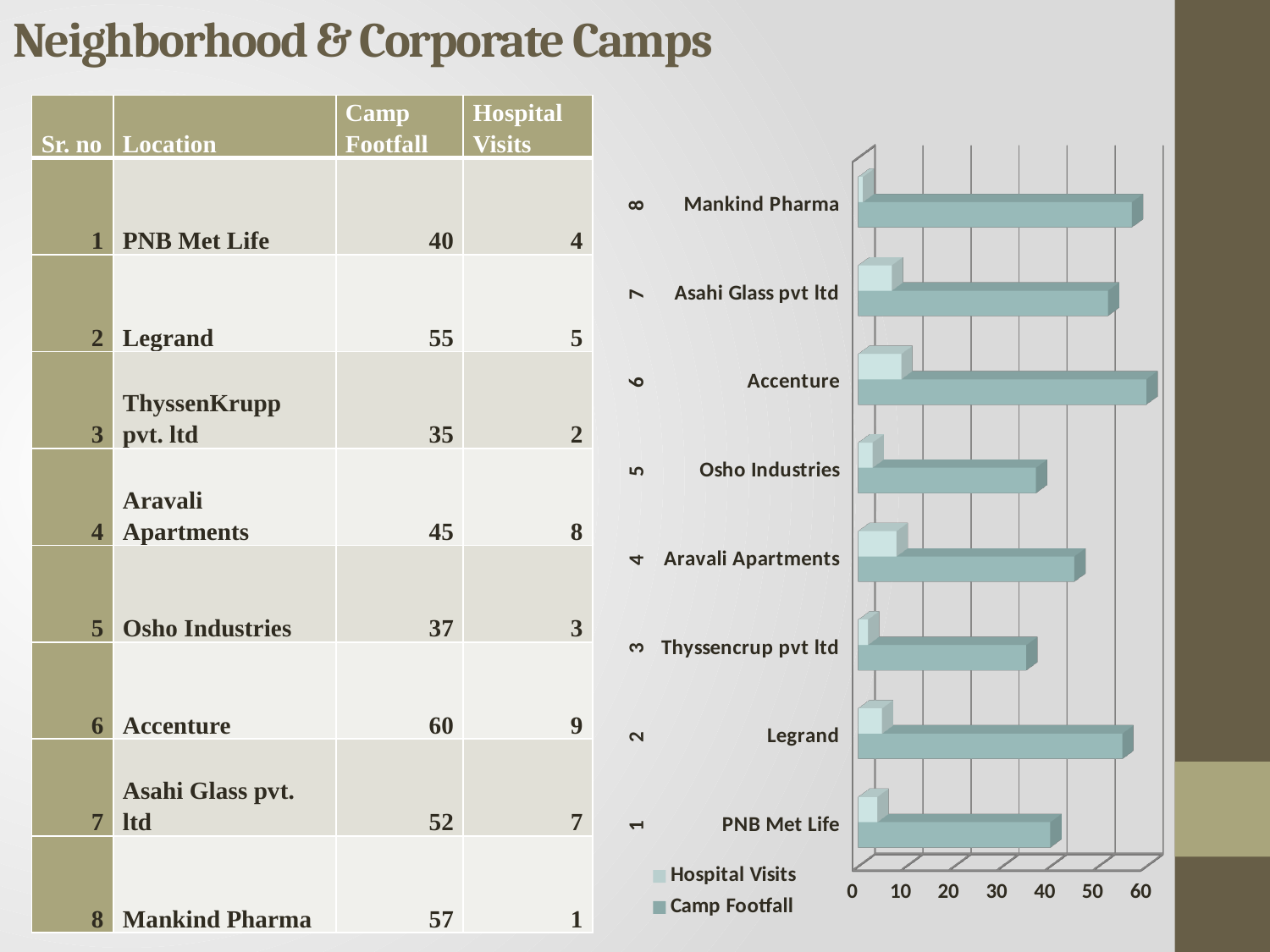
Which has the larger Camp Footfall, Aravali Apartments or Thyssencrup pvt ltd? Aravali Apartments Which location has the lowest Camp Footfall on the chart? Thyssencrup pvt ltd Is the Camp Footfall value for Mankind Pharma greater or less than 50? greater How many series does the chart legend list? 2 What is the Hospital Visits value for Aravali Apartments? 8 Is the Camp Footfall value for Osho Industries greater or less than 40? less Which location has the lowest Hospital Visits on the chart? Mankind Pharma Which location has the highest Camp Footfall on the chart? Accenture How many locations are plotted on the chart? 8 What is the Camp Footfall value for Accenture? 60 What is the difference in Camp Footfall between Accenture and ThyssenKrupp pvt. ltd? 25 What kind of chart is shown on the slide? bar chart